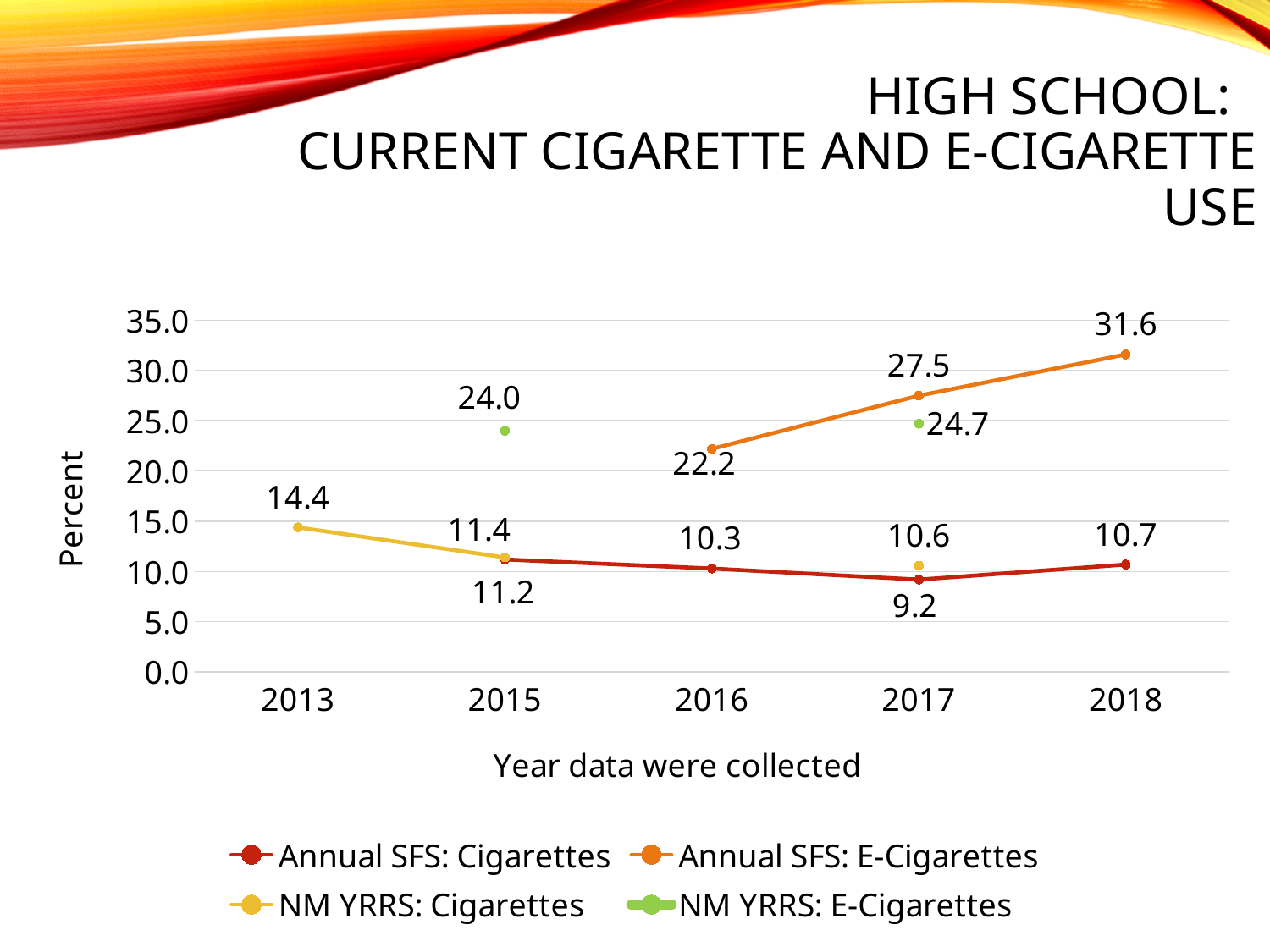
How many series does the legend list? 4 Which is larger in 2017: Annual SFS: E-Cigarettes or NM YRRS: E-Cigarettes? Annual SFS: E-Cigarettes Does the Annual SFS: E-Cigarettes series rise or fall from 2016 to 2018? rise What is the value for NM YRRS: Cigarettes in 2013? 14.4 How many years are shown on the x axis? 5 What type of chart is shown on the slide? line chart What is the value for NM YRRS: E-Cigarettes in 2017? 24.7 What is the value for Annual SFS: E-Cigarettes in 2018? 31.6 In which year is the Annual SFS: E-Cigarettes value highest? 2018 What is the difference between the Annual SFS: E-Cigarettes values in 2018 and 2016? 9.4 In which year is the Annual SFS: Cigarettes value lowest? 2017 What is the value for Annual SFS: Cigarettes in 2017? 9.2